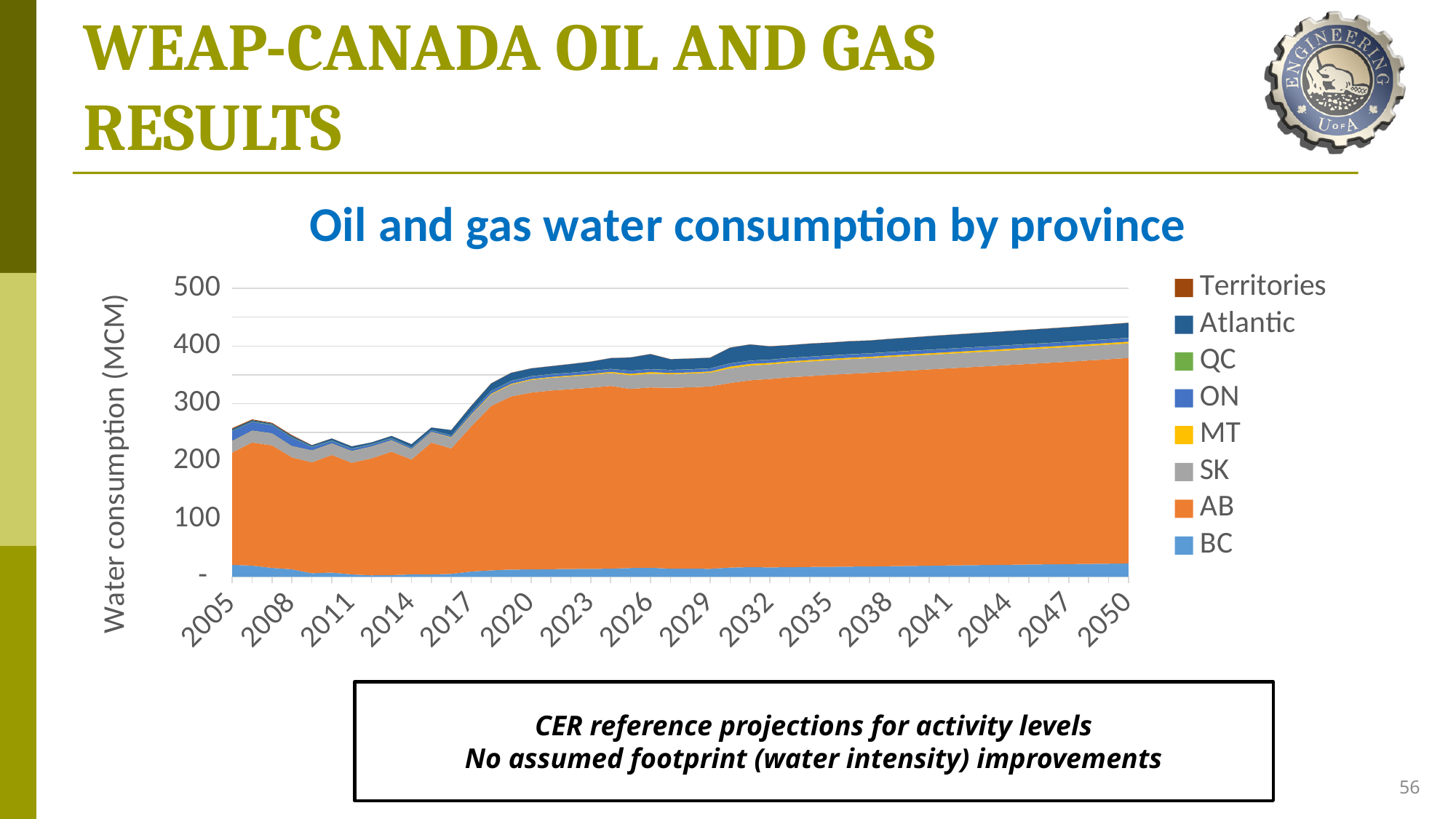
Is the total water consumption in 2020 greater or less than 300 MCM? greater Which province accounts for the largest share of oil and gas water consumption throughout the period? AB What is the first year shown on the horizontal axis? 2005 What is the title of the chart? Oil and gas water consumption by province Is the total water consumption in 2005 greater or less than 300 MCM? less What type of chart is shown on the slide? Stacked area chart Is the total water consumption in 2050 greater or less than 400 MCM? greater What is the last year shown on the horizontal axis? 2050 How many series does the legend of the chart list? 8 Is the total water consumption in 2050 larger or smaller than in 2005? larger What is the label of the vertical axis? Water consumption (MCM) Does total water consumption rise or fall between 2017 and 2050? rise